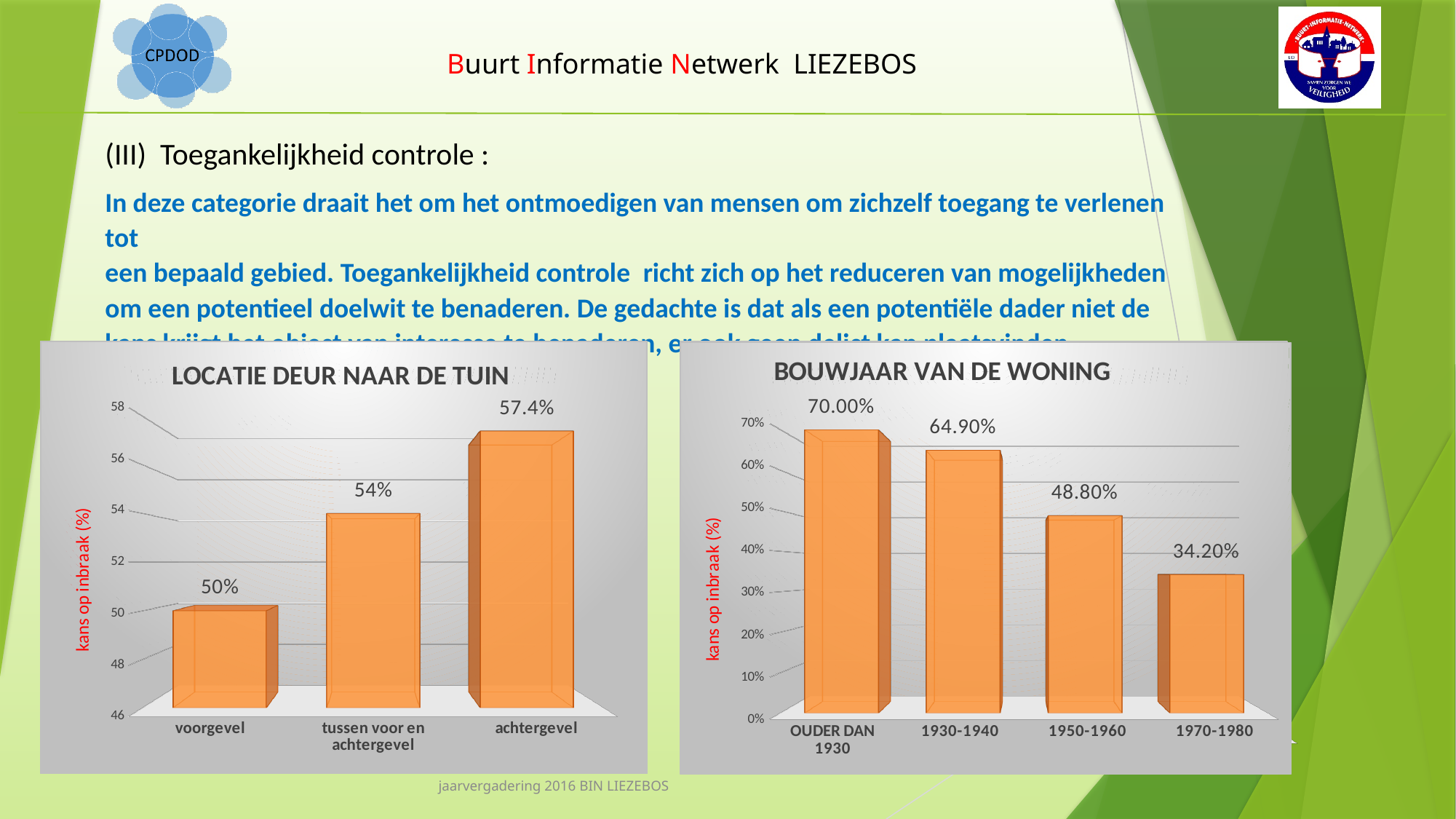
In the 'LOCATIE DEUR NAAR DE TUIN' chart, which category has the lowest value? voorgevel In the 'LOCATIE DEUR NAAR DE TUIN' chart, do the values rise or fall from left to right? rise In the 'BOUWJAAR VAN DE WONING' chart, what is the value for 1970-1980? 34.20% What kind of chart is the 'BOUWJAAR VAN DE WONING' chart? bar chart In the 'BOUWJAAR VAN DE WONING' chart, which is larger: 1930-1940 or 1950-1960? 1930-1940 In the 'BOUWJAAR VAN DE WONING' chart, what is the difference between OUDER DAN 1930 and 1930-1940? 5.10% In the 'BOUWJAAR VAN DE WONING' chart, which category has the highest value? OUDER DAN 1930 In the 'LOCATIE DEUR NAAR DE TUIN' chart, what is the value for voorgevel? 50% In the 'BOUWJAAR VAN DE WONING' chart, what is the value for 1950-1960? 48.80% In the 'LOCATIE DEUR NAAR DE TUIN' chart, how many categories are shown? 3 In the 'LOCATIE DEUR NAAR DE TUIN' chart, what is the value for achtergevel? 57.4% In the 'LOCATIE DEUR NAAR DE TUIN' chart, what is the difference between achtergevel and tussen voor en achtergevel? 3.4%